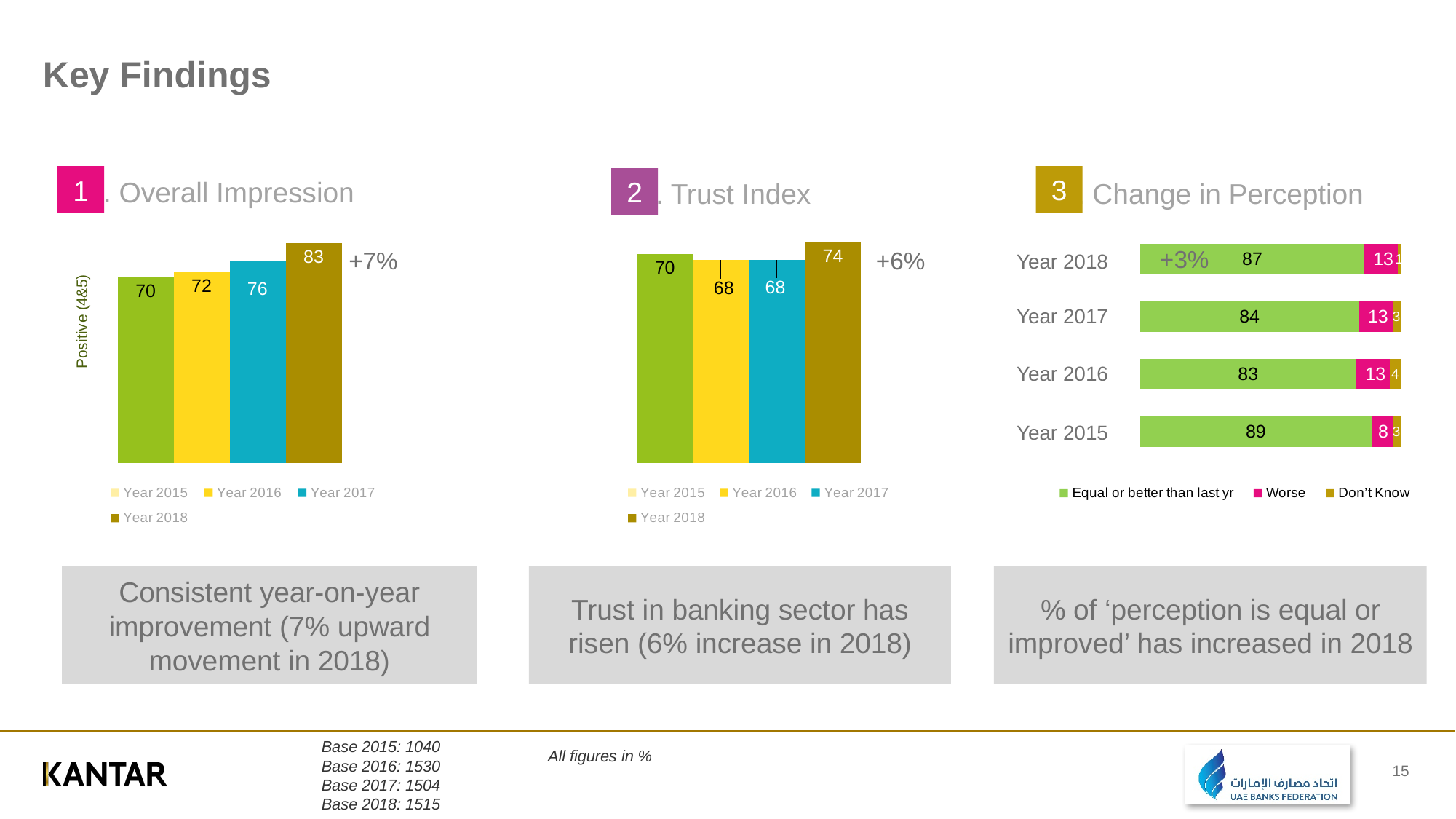
In the Change in Perception chart, what is the 'Equal or better than last yr' value for Year 2017? 84 In the Overall Impression chart, what is the value for Year 2018? 83 In the Overall Impression chart, which year has the lowest value? Year 2015 In the Trust Index chart, what is the difference between Year 2018 and Year 2016? 6 In the Overall Impression chart, what is the difference between Year 2018 and Year 2017? 7 What kind of chart is the Change in Perception chart? stacked bar chart In the Trust Index chart, which year has the highest value? Year 2018 In the Change in Perception chart, what is the 'Worse' value for Year 2015? 8 In the Change in Perception chart, which year has the highest 'Equal or better than last yr' value? Year 2015 In the Overall Impression chart, do the values rise or fall from Year 2015 to Year 2018? rise In the Trust Index chart, what is the value for Year 2015? 70 In the Trust Index chart, how many series does the legend list? 4